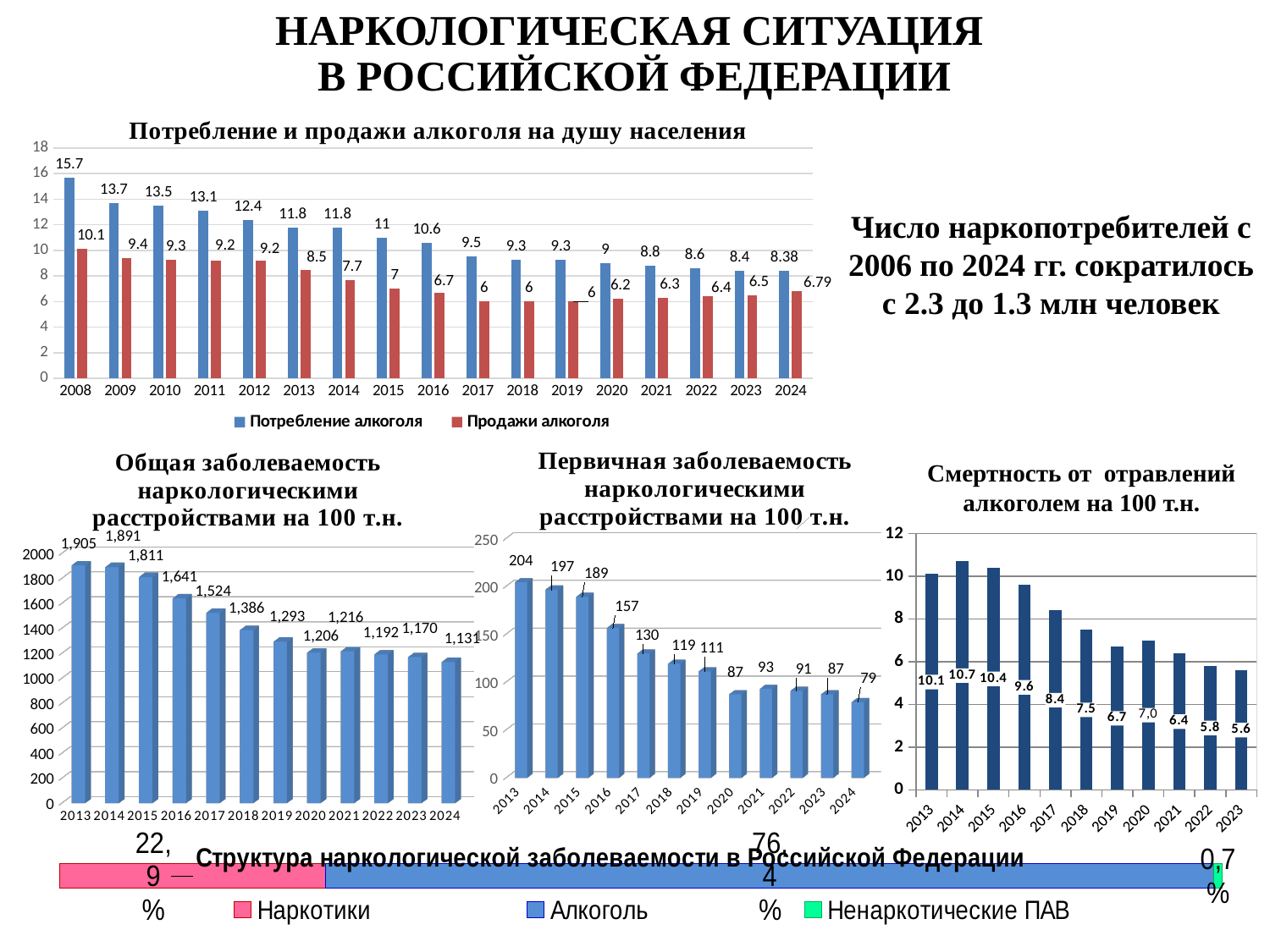
What kind of chart is 'Общая заболеваемость наркологическими расстройствами на 100 т.н.'? bar chart In the chart 'Первичная заболеваемость наркологическими расстройствами на 100 т.н.', what is the value for 2016? 157 In the chart 'Потребление и продажи алкоголя на душу населения', what is the difference between 'Потребление алкоголя' and 'Продажи алкоголя' in 2015? 4 In the chart 'Смертность от отравлений алкоголем на 100 т.н.', which year has the highest value? 2014 In the chart 'Потребление и продажи алкоголя на душу населения', what is the value of 'Потребление алкоголя' for 2008? 15.7 In the chart 'Смертность от отравлений алкоголем на 100 т.н.', do the values generally rise or fall from 2015 to 2023? fall In the chart 'Структура наркологической заболеваемости в Российской Федерации', what share does 'Алкоголь' have? 76,4% In the chart 'Потребление и продажи алкоголя на душу населения', what is the value of 'Продажи алкоголя' for 2024? 6.79 In the chart 'Общая заболеваемость наркологическими расстройствами на 100 т.н.', what is the value for 2024? 1,131 In the chart 'Первичная заболеваемость наркологическими расстройствами на 100 т.н.', which year has the lowest value? 2024 In the chart 'Потребление и продажи алкоголя на душу населения', how many series does the legend list? 2 In the chart 'Общая заболеваемость наркологическими расстройствами на 100 т.н.', which year has the highest value? 2013